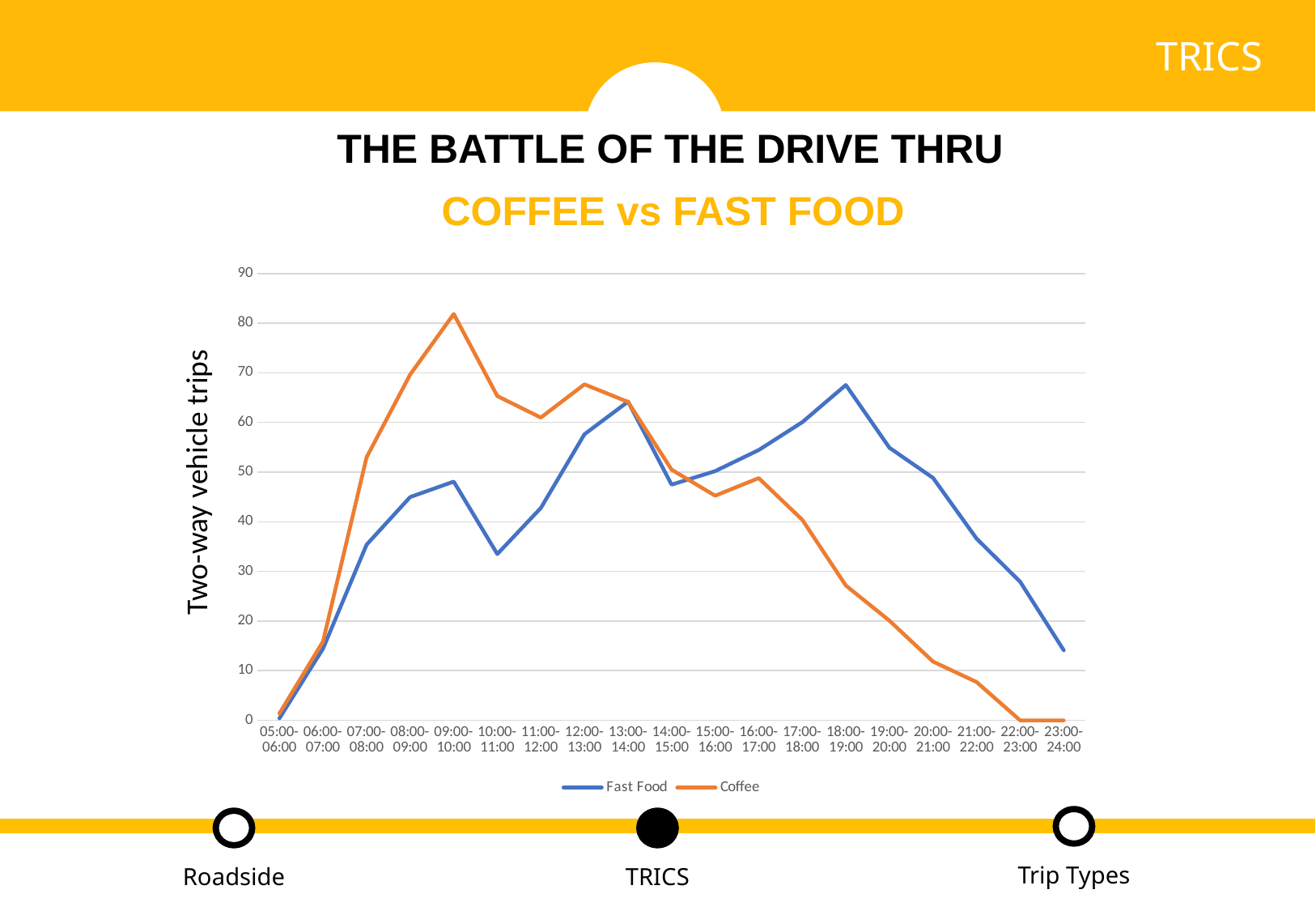
In which time period does the Fast Food series reach its highest value? 18:00-19:00 In which time period does the Coffee series reach its highest value? 09:00-10:00 Is the Fast Food value for 18:00-19:00 greater or less than 60? greater Which series has the higher value in the 09:00-10:00 period, Fast Food or Coffee? Coffee How many series does the legend list? 2 Is the Coffee value for 09:00-10:00 greater or less than 80? greater Does the Coffee series rise or fall from 13:00-14:00 to 23:00-24:00? Fall Is the Fast Food value for 23:00-24:00 greater or less than 20? less What is the label on the vertical axis? Two-way vehicle trips How many time periods are plotted along the x axis? 19 What kind of chart is shown on the slide? Line chart Which series has the higher value in the 18:00-19:00 period, Fast Food or Coffee? Fast Food